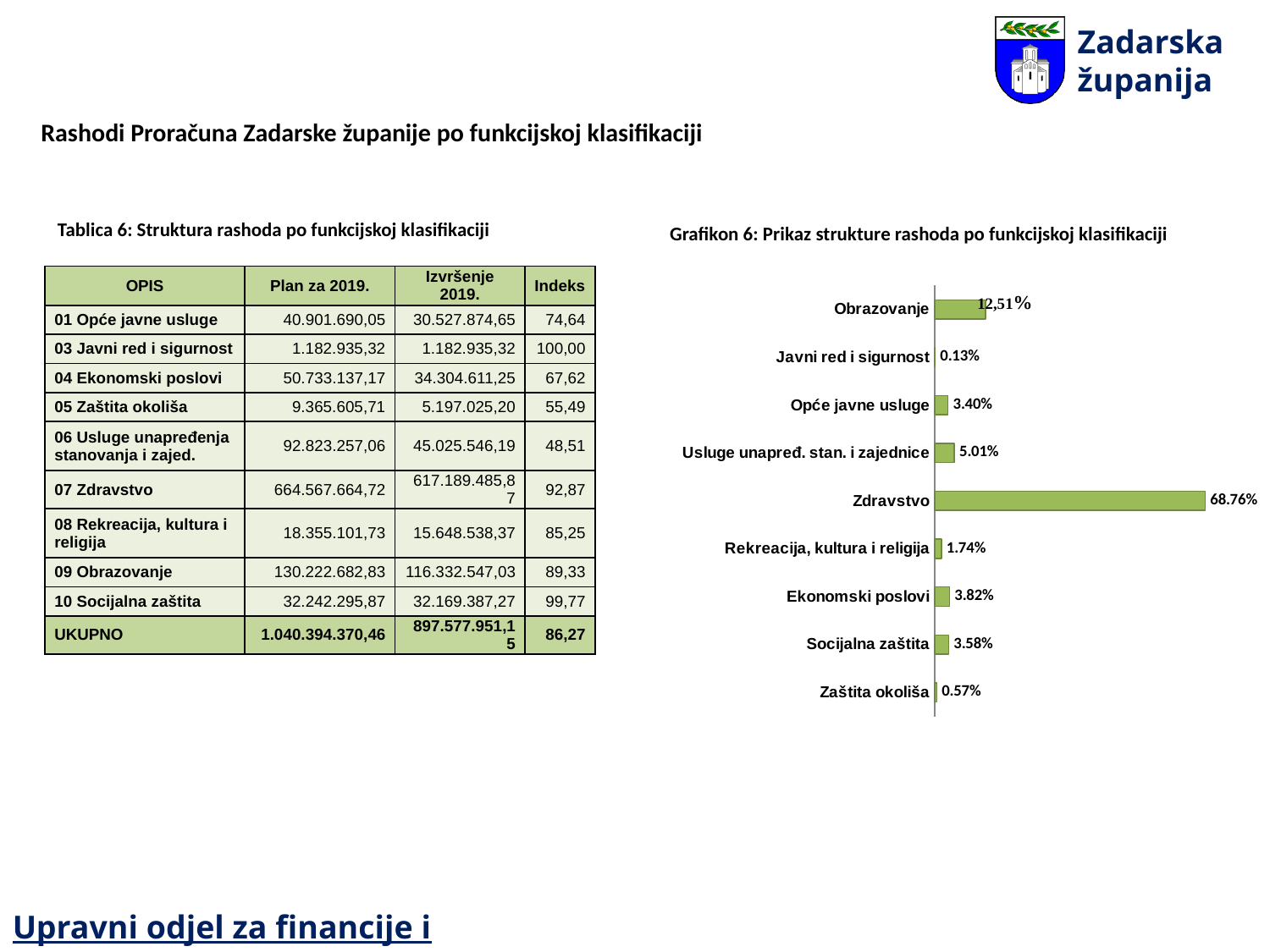
In Grafikon 6, what is the value for Zaštita okoliša? 0.57% In Grafikon 6, which category has the lowest share? Javni red i sigurnost In Grafikon 6, what is the difference between Usluge unapređ. stan. i zajednice and Opće javne usluge? 1.61% What kind of chart is Grafikon 6? bar chart In Grafikon 6, which is larger: Ekonomski poslovi or Socijalna zaštita? Ekonomski poslovi What is the title of the chart on the slide? Grafikon 6: Prikaz strukture rashoda po funkcijskoj klasifikaciji In Grafikon 6, what is the value for Ekonomski poslovi? 3.82% In Grafikon 6, what is the value for Zdravstvo? 68.76% In Grafikon 6, what is the value for Rekreacija, kultura i religija? 1.74% How many categories are shown in Grafikon 6? 9 In Grafikon 6, what is the value for Usluge unapređ. stan. i zajednice? 5.01% In Grafikon 6, which category has the highest share? Zdravstvo